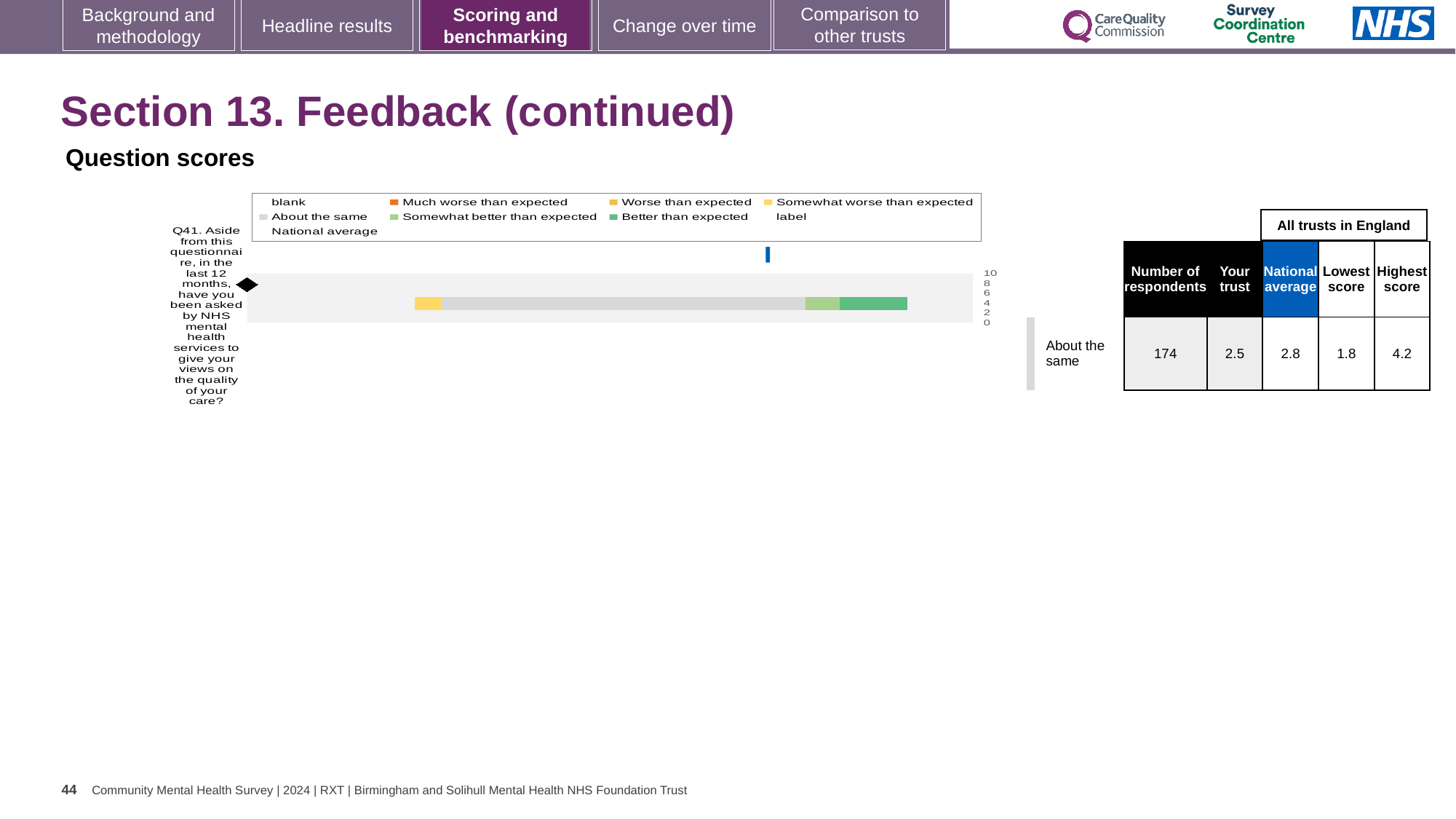
According to the table beside the chart, what is the highest score among all trusts in England for Q41? 4.2 According to the table beside the chart, what is the lowest score among all trusts in England for Q41? 1.8 How many survey questions are plotted on the chart? 1 According to the table beside the chart, how many respondents answered Q41? 174 What is the difference between the highest score and the lowest score for Q41 in the table beside the chart? 2.4 Is the trust's score for Q41 higher or lower than the national average? lower What kind of chart is shown on the slide? bar chart Which question number is plotted on the chart? Q41 According to the table beside the chart, what is the national average score for Q41? 2.8 What is the highest tick value shown on the chart's axis? 10 What benchmark category is the trust's Q41 score placed in, as labelled next to the chart? About the same According to the table beside the chart, what is the 'Your trust' score for Q41? 2.5